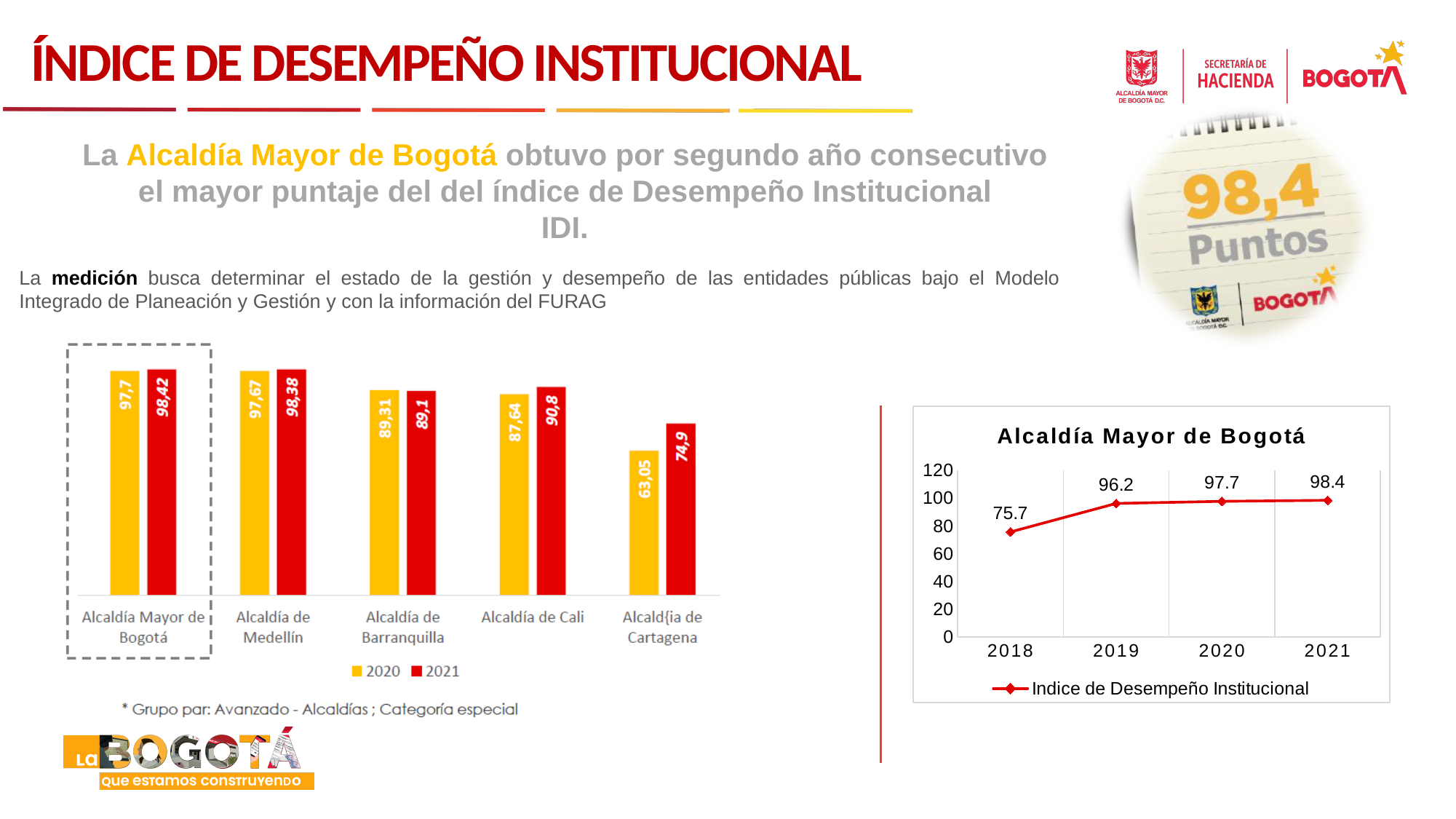
In the bar chart on the left, what is the 2021 value for Alcaldía de Cali? 90,8 In the bar chart on the left, what is the difference between the 2021 and 2020 values for Alcaldía de Cartagena? 11,85 In the line chart titled 'Alcaldía Mayor de Bogotá', what series name does the legend show? Indice de Desempeño Institucional In the line chart titled 'Alcaldía Mayor de Bogotá', what is the value for 2018? 75.7 In the line chart titled 'Alcaldía Mayor de Bogotá', what is the difference between the 2019 and 2018 values? 20.5 In the line chart titled 'Alcaldía Mayor de Bogotá', which year has the lowest value? 2018 In the line chart titled 'Alcaldía Mayor de Bogotá', do the values rise or fall from 2018 to 2021? rise In the line chart titled 'Alcaldía Mayor de Bogotá', what is the value for 2021? 98.4 In the bar chart on the left, which alcaldía has the lowest 2021 value? Alcaldía de Cartagena In the bar chart on the left, how many series does the legend list? 2 In the bar chart on the left, what is the 2020 value for Alcaldía de Cartagena? 63,05 In the line chart titled 'Alcaldía Mayor de Bogotá', how many years are plotted? 4